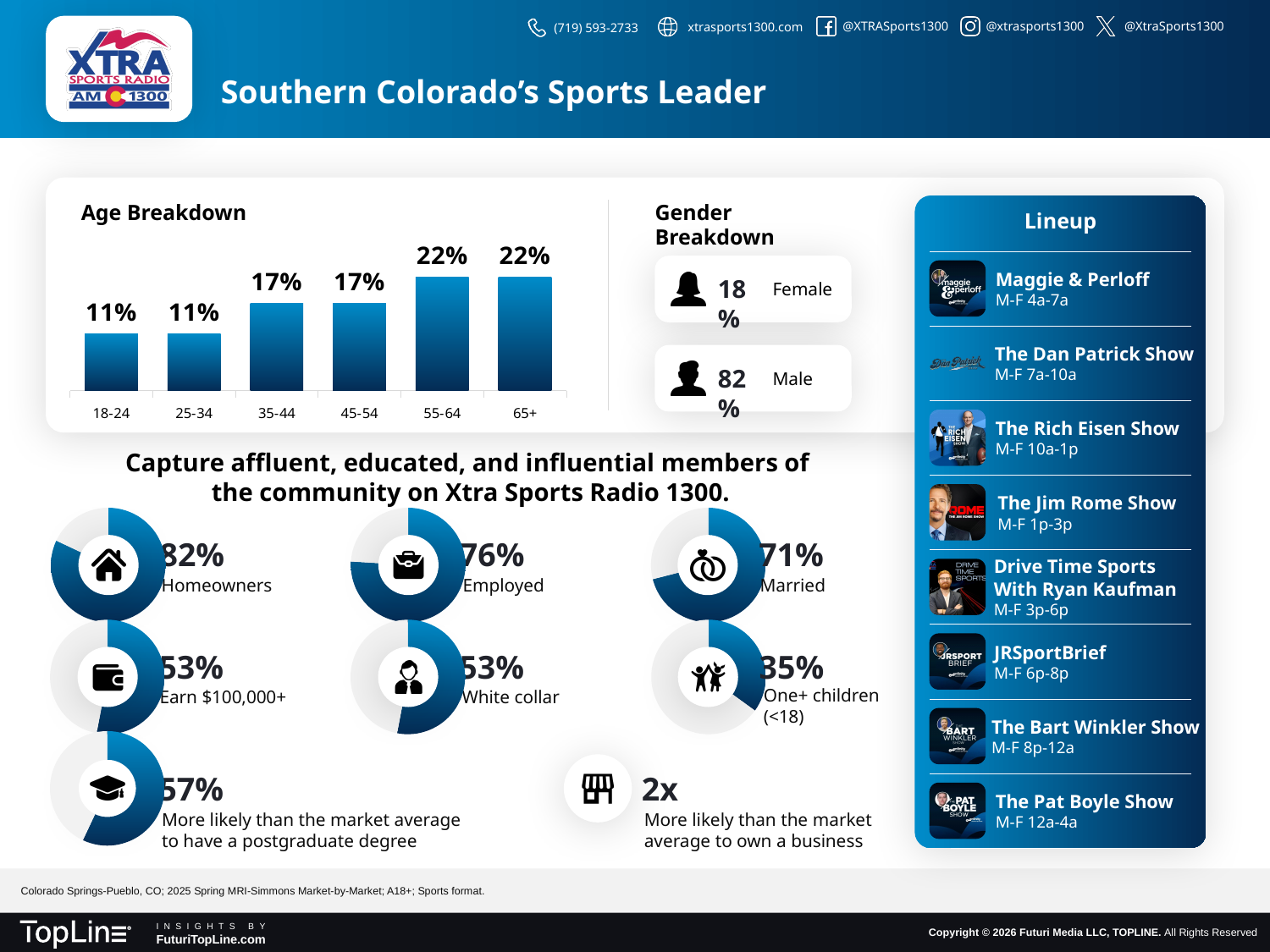
In the Age Breakdown chart, which is larger, the value for 45-54 or the value for 18-24? 45-54 What kind of chart is the Age Breakdown chart? bar chart In the Age Breakdown chart, what is the value for the 35-44 age group? 17% In the donut chart for Homeowners, what percentage is shown? 82% In the Age Breakdown chart, what is the lowest value shown? 11% How many age groups are shown in the Age Breakdown chart? 6 In the Age Breakdown chart, what is the difference between the 55-64 and 25-34 values? 11% In the Age Breakdown chart, do the values generally rise or fall from 18-24 to 65+? rise In the Age Breakdown chart, what is the value for the 65+ age group? 22% In the Age Breakdown chart, what is the value for the 18-24 age group? 11% In the Age Breakdown chart, what is the highest value shown? 22% In the donut chart for One+ children (<18), what percentage is shown? 35%